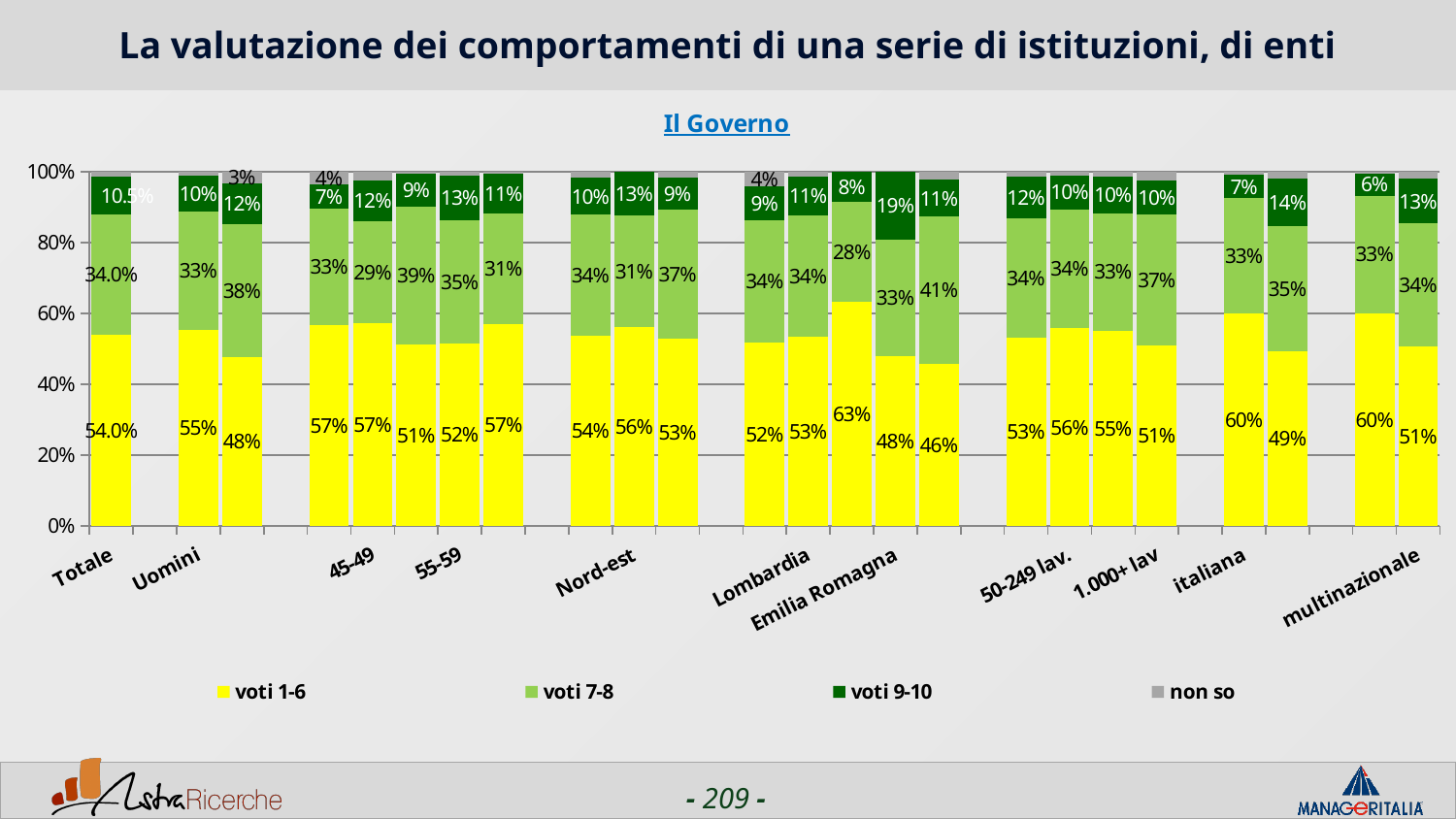
What is the value of 'voti 9-10' for Emilia Romagna? 19% Which series has the largest share in the Totale bar? voti 1-6 What is the value of 'voti 9-10' for multinazionale? 13% What is the value of 'voti 1-6' for italiana? 60% What is the value of 'voti 1-6' for Totale? 54.0% What is the value of 'voti 7-8' for Totale? 34.0% What is the difference between 'voti 1-6' and 'voti 7-8' for Totale? 20.0% What kind of chart is shown on the slide? stacked bar chart How many series does the legend list? 4 What is the value of 'voti 1-6' for Uomini? 55% What is the title of the chart? Il Governo Which colour represents 'voti 1-6' in the legend? yellow